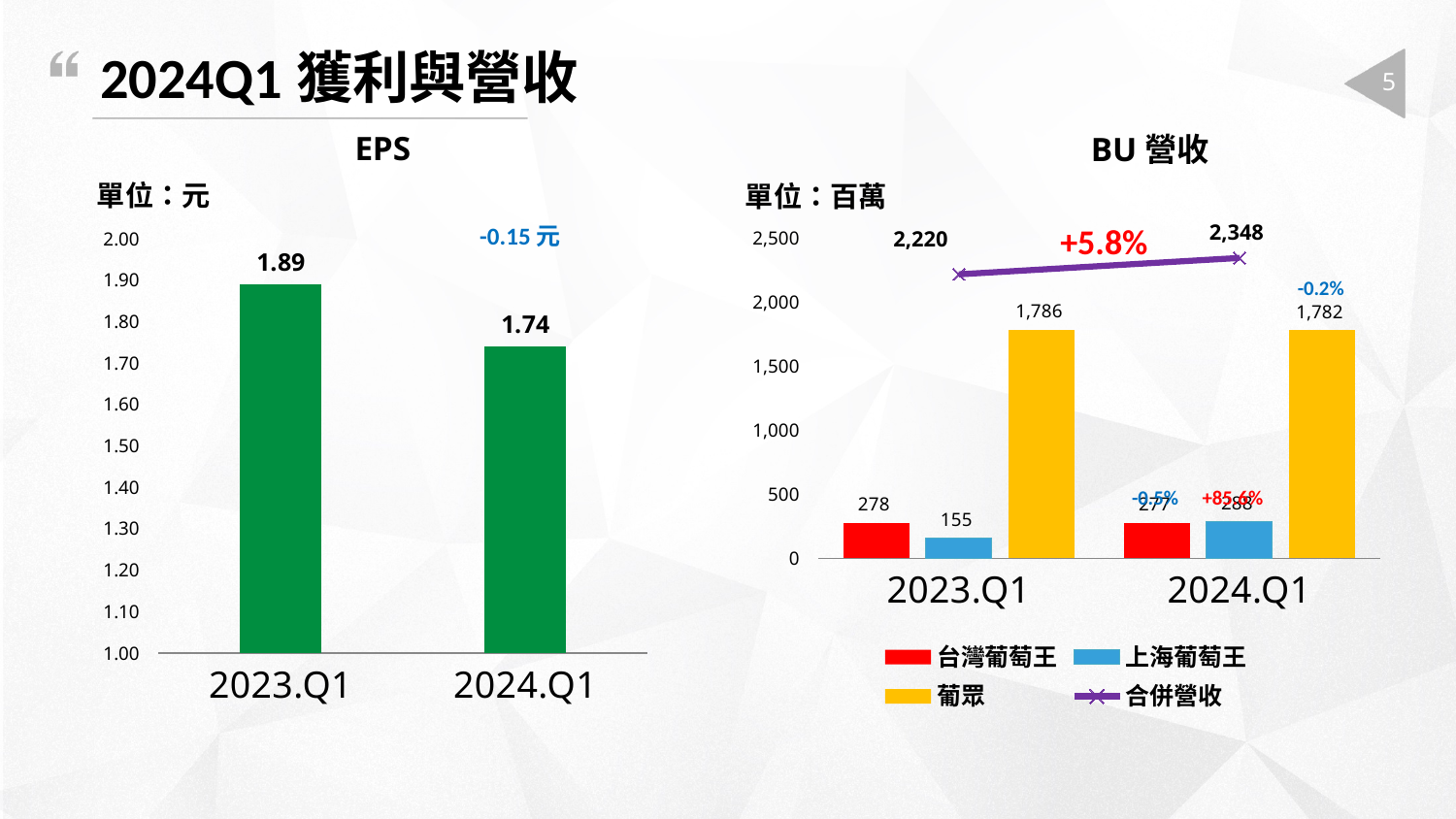
In the EPS chart, what is the EPS value for 2024.Q1? 1.74 In the BU 營收 chart, how many series does the legend list? 4 In the BU 營收 chart, what is the value for 葡眾 in 2024.Q1? 1,782 What kind of chart is the EPS chart? bar chart In the EPS chart, what is the EPS value for 2023.Q1? 1.89 In the EPS chart, what is the difference between the 2023.Q1 and 2024.Q1 EPS values? 0.15 In the BU 營收 chart, is the value for 台灣葡萄王 in 2023.Q1 greater or less than 500? less In the BU 營收 chart, what is the value for 葡眾 in 2023.Q1? 1,786 In the BU 營收 chart, what is the value for 上海葡萄王 in 2023.Q1? 155 In the BU 營收 chart, what is the difference between the 合併營收 values for 2024.Q1 and 2023.Q1? 128 In the BU 營收 chart, what is the 合併營收 value for 2024.Q1? 2,348 In the EPS chart, which quarter has the higher EPS, 2023.Q1 or 2024.Q1? 2023.Q1